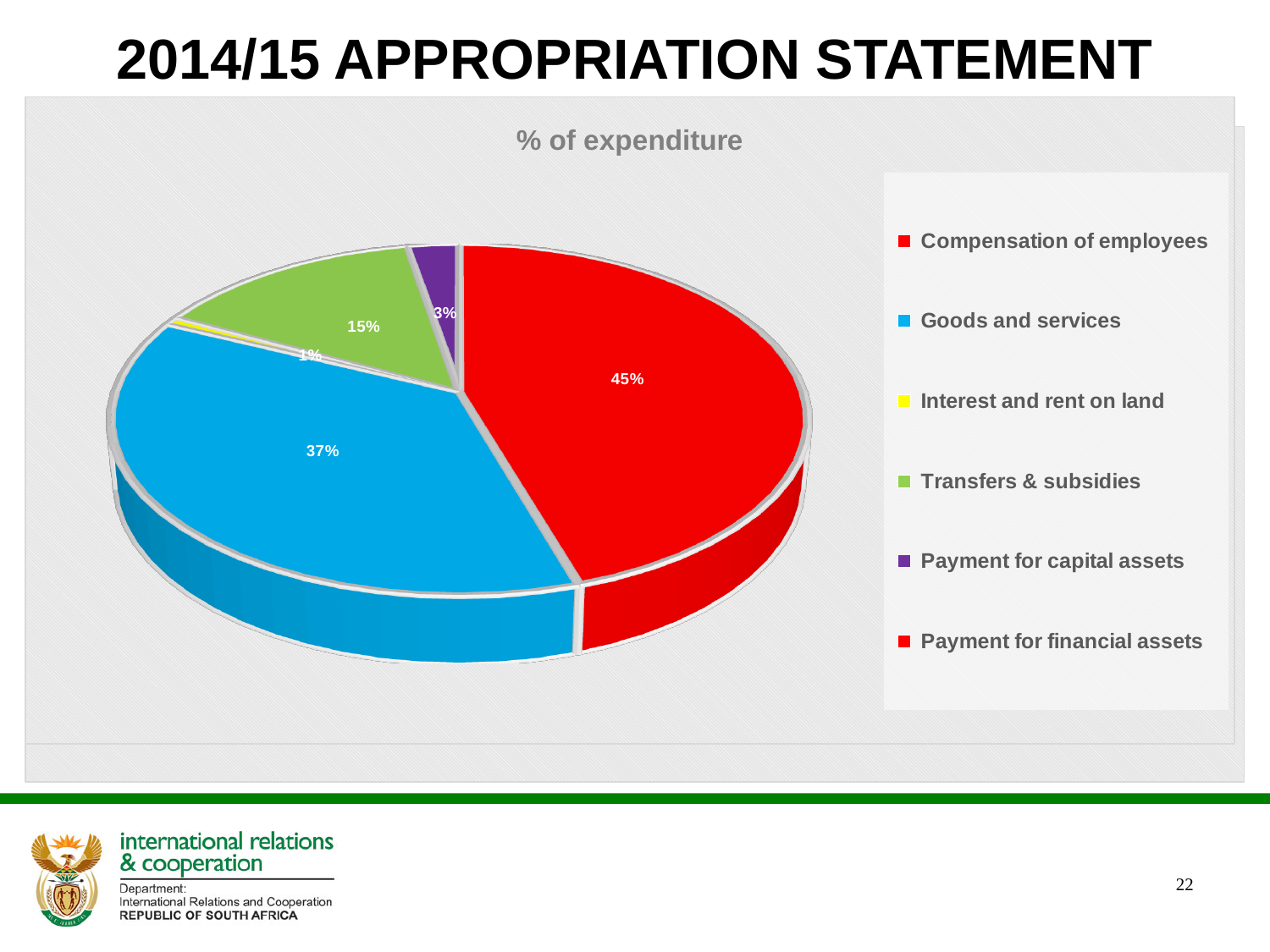
Which is larger: Transfers & subsidies or Payment for capital assets? Transfers & subsidies How many percentage points larger is Compensation of employees than Goods and services? 8 What colour is the Goods and services slice? Blue What percentage of expenditure is Payment for capital assets? 3% What percentage of expenditure is Compensation of employees? 45% What percentage of expenditure is Goods and services? 37% How many categories does the legend list? 6 What is the title of the chart? % of expenditure What kind of chart is shown on the slide? Pie chart What percentage of expenditure is Transfers & subsidies? 15% What is the combined share of Compensation of employees and Goods and services? 82% Which category has the largest share of expenditure? Compensation of employees